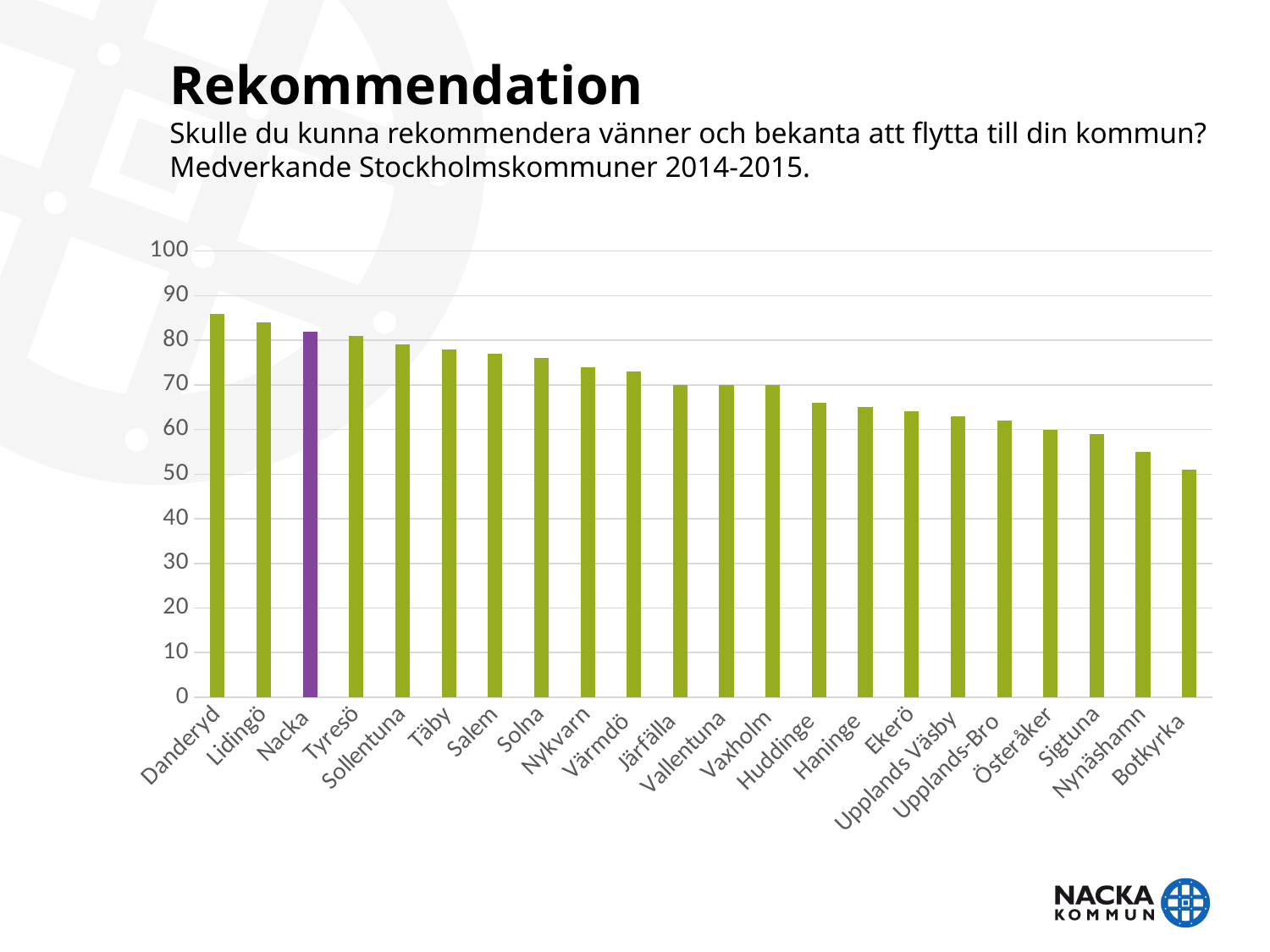
Is the value for Täby greater or less than 70? greater Which municipality has the highest value? Danderyd Which municipality's bar is highlighted in a different colour (purple) from the others? Nacka Is the value for Huddinge greater or less than 70? less Is the value for Danderyd greater or less than 80? greater What kind of chart is shown on the slide? bar chart Which has a larger value, Nacka or Huddinge? Nacka How many municipalities (categories) are shown on the x axis? 22 Do the values rise or fall from left to right along the x axis? fall Which municipality has the lowest value? Botkyrka Which has a larger value, Sigtuna or Solna? Solna